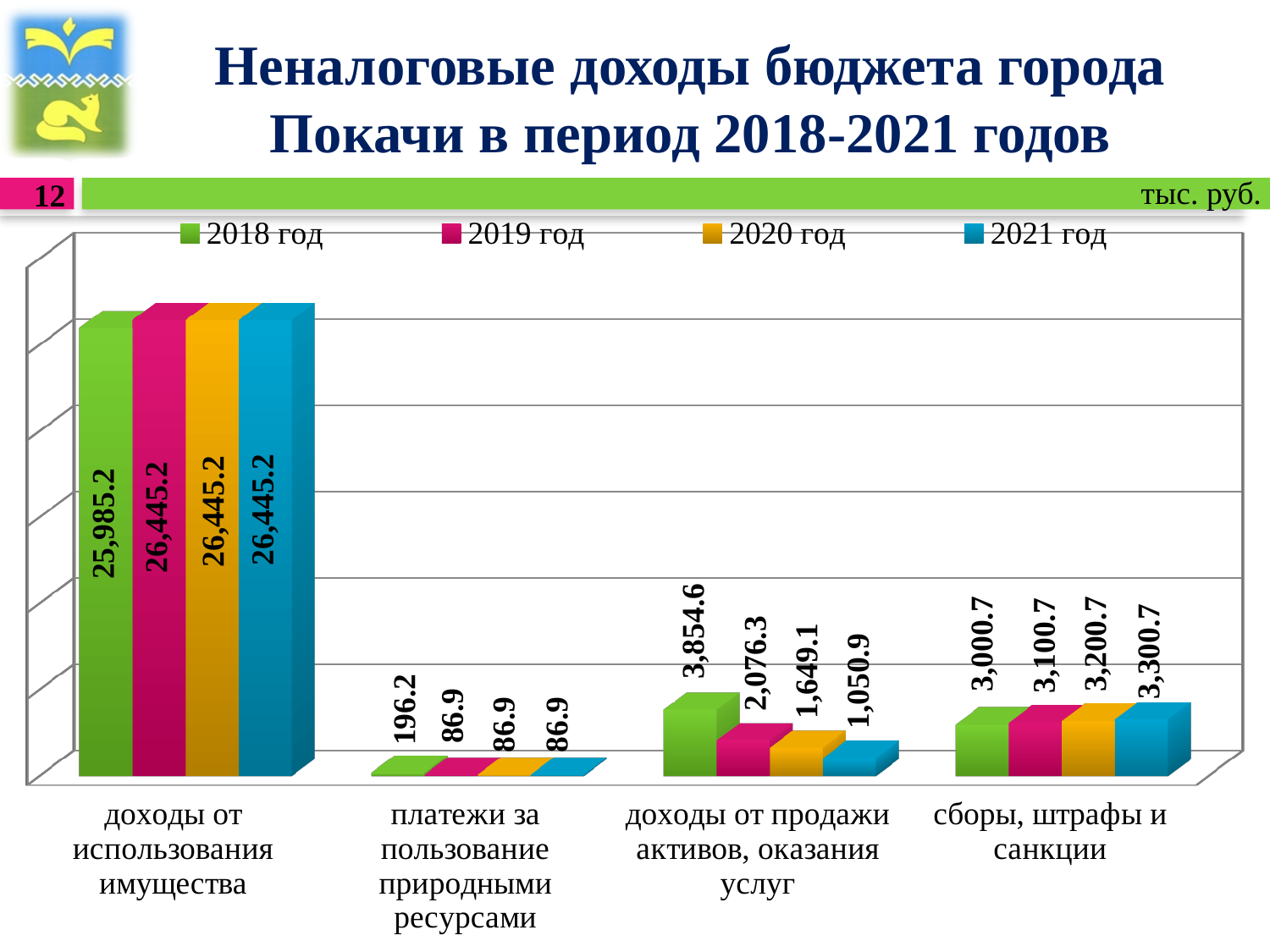
Which category has the highest values across all years? доходы от использования имущества What is the value for 2020 год in the category «сборы, штрафы и санкции»? 3,200.7 How many categories are shown on the x axis? 4 What is the difference between the 2018 год and 2021 год values for «доходы от продажи активов, оказания услуг»? 2,803.7 What is the value for 2019 год in the category «платежи за пользование природными ресурсами»? 86.9 Which category has the lowest values across all years? платежи за пользование природными ресурсами Which is larger for «сборы, штрафы и санкции»: the 2018 год value or the 2021 год value? 2021 год What is the difference between the 2019 год and 2018 год values for «доходы от использования имущества»? 460.0 What is the value for 2018 год in the category «доходы от использования имущества»? 25,985.2 What kind of chart is shown on the slide? bar chart How many series does the legend list? 4 What is the value for 2021 год in the category «доходы от продажи активов, оказания услуг»? 1,050.9